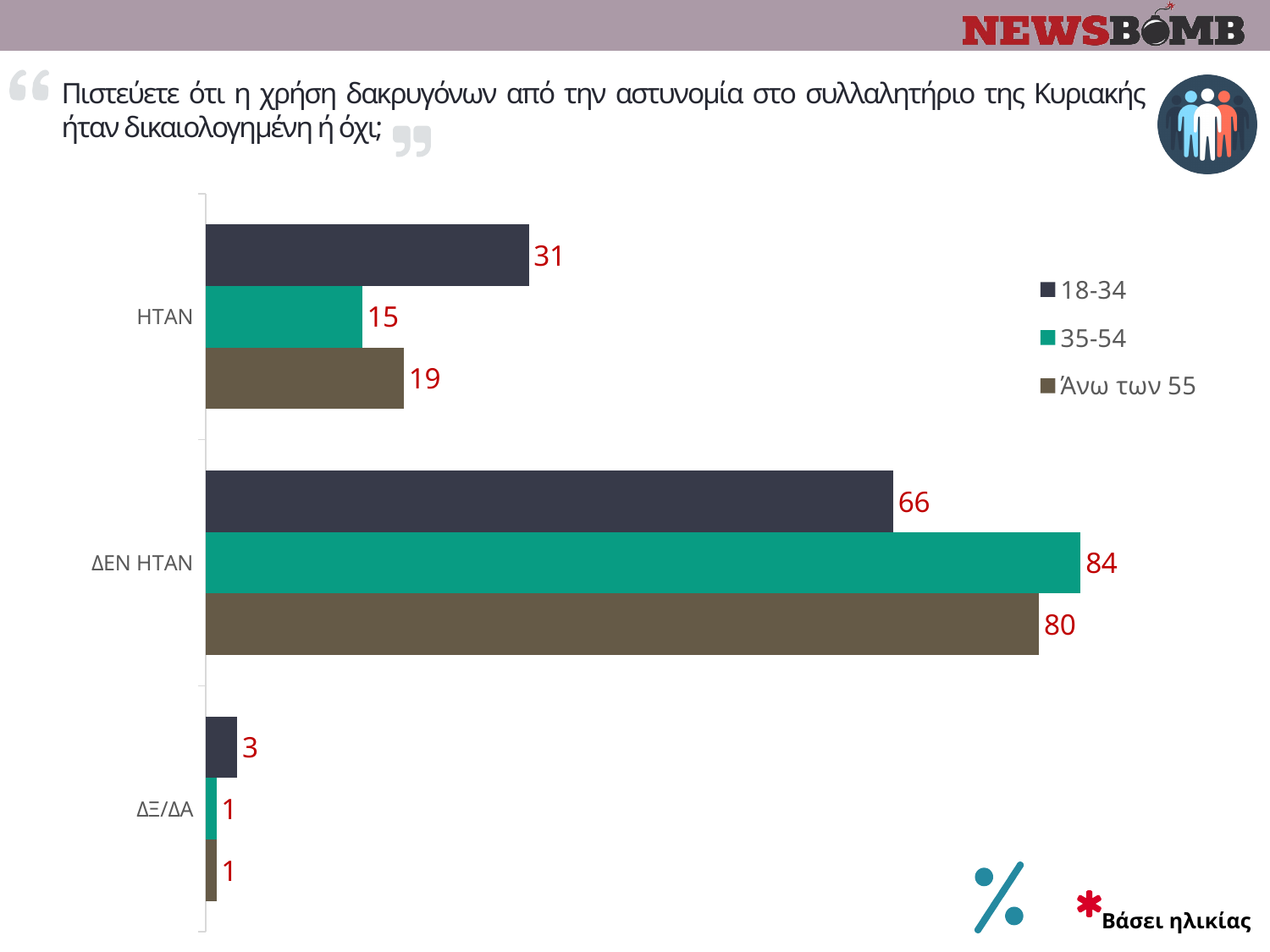
What is the difference between the 35-54 and 18-34 values in the ΔΕΝ ΗΤΑΝ category? 18 How many series does the legend list? 3 What is the value for the 35-54 series in the ΔΕΝ ΗΤΑΝ category? 84 Which is larger: the Άνω των 55 value for ΔΕΝ ΗΤΑΝ or the 18-34 value for ΔΕΝ ΗΤΑΝ? Άνω των 55 What is the value for the Άνω των 55 series in the ΗΤΑΝ category? 19 What colour represents the 35-54 series in the legend? Green Which series has the highest value in the ΔΕΝ ΗΤΑΝ category? 35-54 What kind of chart is shown on the slide? Bar chart What is the value for the 18-34 series in the ΗΤΑΝ category? 31 How many categories are shown on the chart? 3 What is the value for the 18-34 series in the ΔΞ/ΔΑ category? 3 Which series has the lowest value in the ΗΤΑΝ category? 35-54